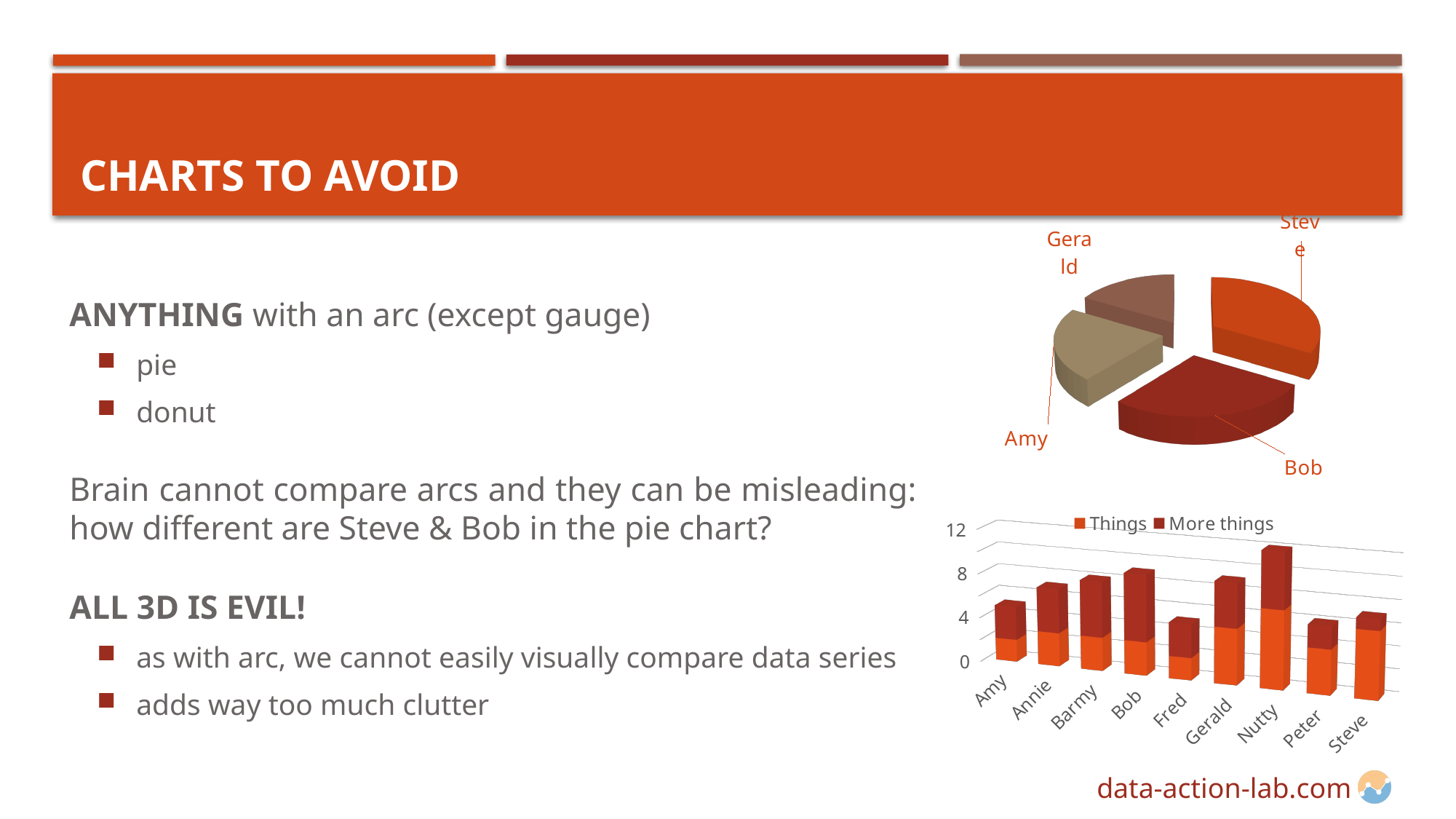
In the bar chart at the bottom right, is the total stacked value for Steve greater or less than 8? less In the bar chart at the bottom right, which stacked bar is taller, Nutty or Fred? Nutty In the bar chart at the bottom right, is the total stacked value for Gerald greater or less than 4? greater What kind of chart is shown at the bottom right of the slide? bar chart How many series does the legend of the bar chart at the bottom right list? 2 In the bar chart at the bottom right, which colour represents the 'Things' series? orange In the bar chart at the bottom right, is the total stacked value for Nutty greater or less than 8? greater How many slices does the pie chart at the top right have? 4 In the bar chart at the bottom right, which category has the tallest stacked bar? Nutty How many categories are shown on the x axis of the bar chart at the bottom right? 9 What kind of chart is shown at the top right of the slide? pie chart What are the two series named in the legend of the bar chart at the bottom right? Things and More things